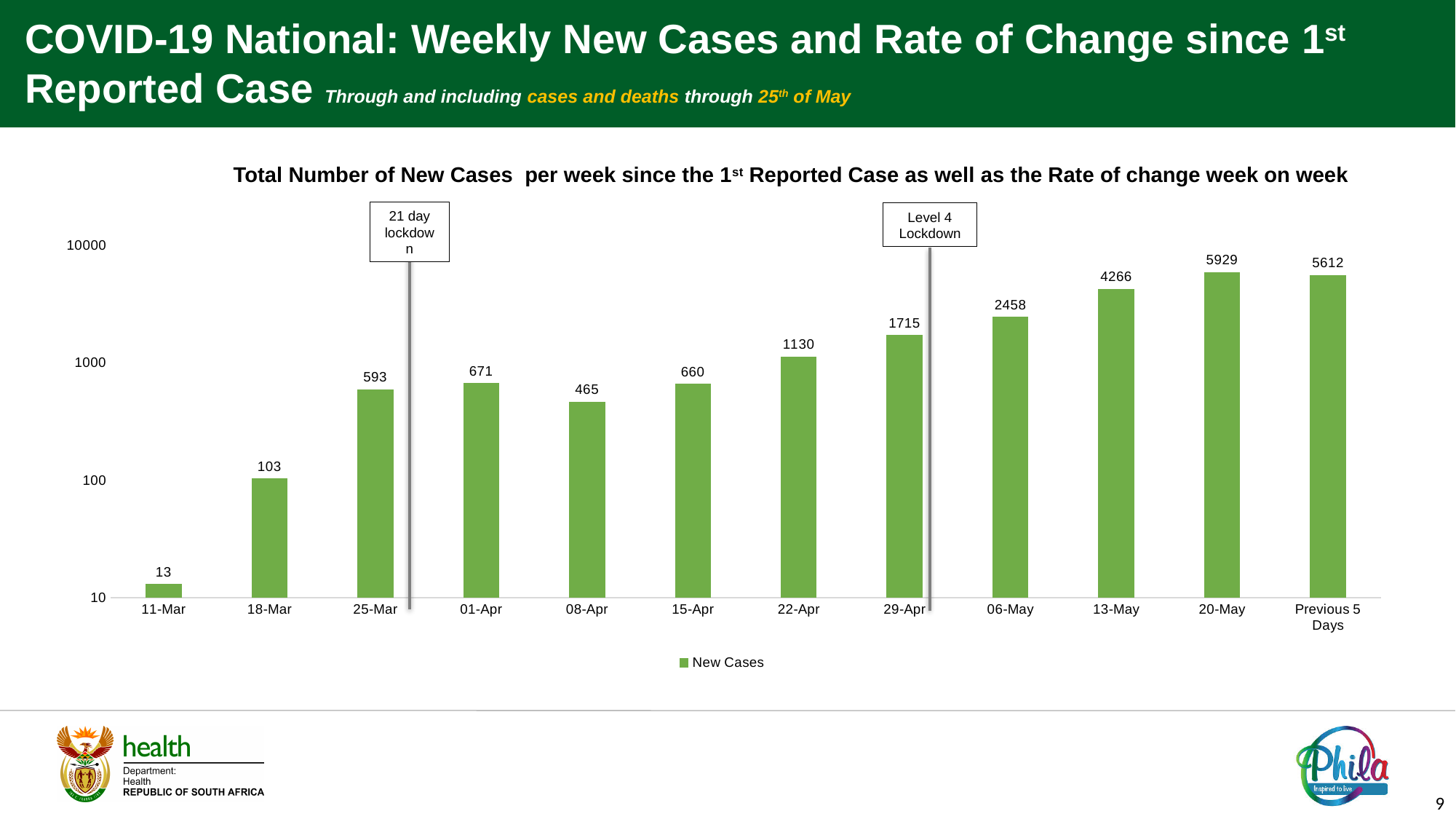
Which week has the lowest number of new cases? 11-Mar What is the number of new cases for the 'Previous 5 Days' category? 5612 What kind of chart is shown on the slide? Bar chart Which has more new cases, 01-Apr or 08-Apr? 01-Apr Which week has the highest number of new cases? 20-May What is the number of new cases for the week of 11-Mar? 13 Is the value for 29-Apr greater or less than 1000? greater What is the difference in new cases between 20-May and 13-May? 1663 What is the number of new cases for the week of 22-Apr? 1130 How many series does the legend list? 1 How many categories are shown on the x axis? 12 What is the name of the series shown in the legend? New Cases